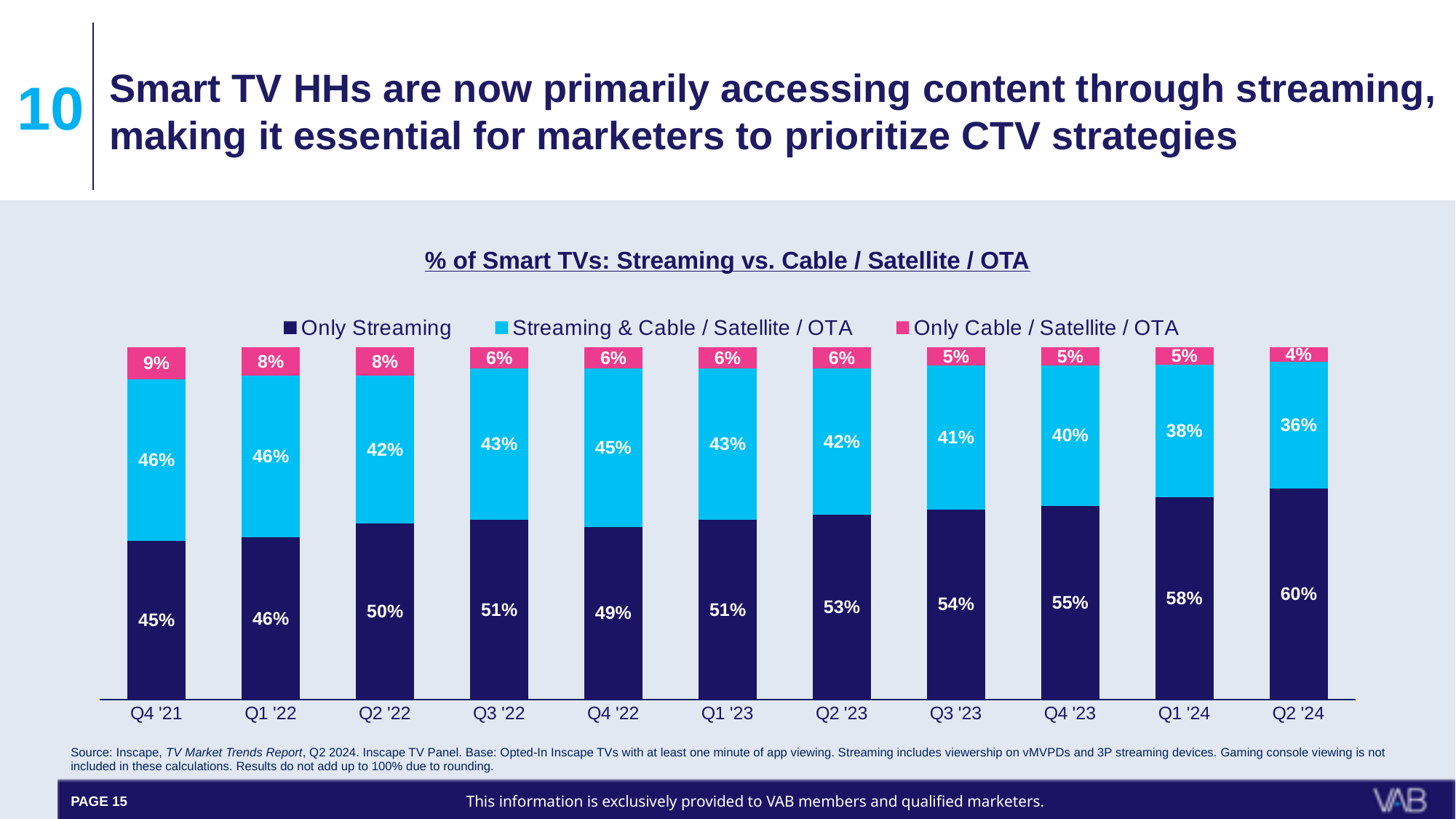
What kind of chart is shown on the slide? Stacked bar chart Which quarter has the larger Only Streaming share, Q4 '22 or Q1 '23? Q1 '23 What is the Only Cable / Satellite / OTA value for Q4 '21? 9% In which quarter is the Only Streaming share highest? Q2 '24 What is the Only Streaming value for Q2 '24? 60% What is the title of the chart? % of Smart TVs: Streaming vs. Cable / Satellite / OTA Does the Only Streaming share generally rise or fall from Q4 '21 to Q2 '24? Rise By how many percentage points did the Only Streaming share increase from Q4 '21 to Q2 '24? 15 percentage points In which quarter is the Only Cable / Satellite / OTA share lowest? Q2 '24 What is the Streaming & Cable / Satellite / OTA value for Q4 '22? 45% How many series does the legend list? 3 How many quarters are shown on the x axis? 11